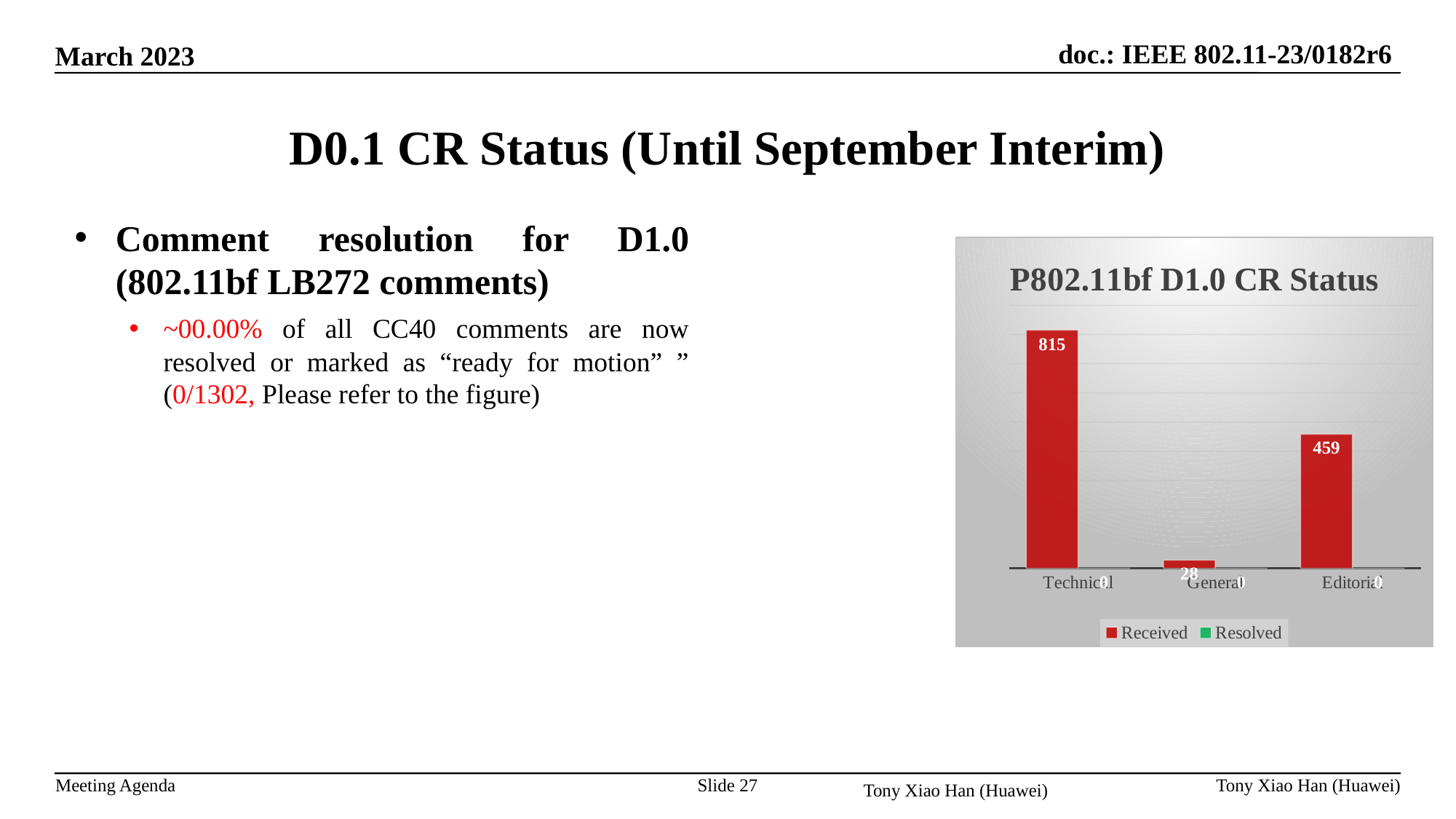
What is the Received value for General? 28 What is the Received value for Editorial? 459 What is the Received value for Technical? 815 Which category has the highest Received value? Technical Which is larger, the Received value for Technical or for Editorial? Technical What is the difference between the Received values for Editorial and General? 431 How many series does the legend list? 2 What kind of chart is shown? bar chart What is the difference between the Received values for Technical and Editorial? 356 Which category has the lowest Received value? General How many categories are shown on the x axis? 3 What is the title of the chart? P802.11bf D1.0 CR Status